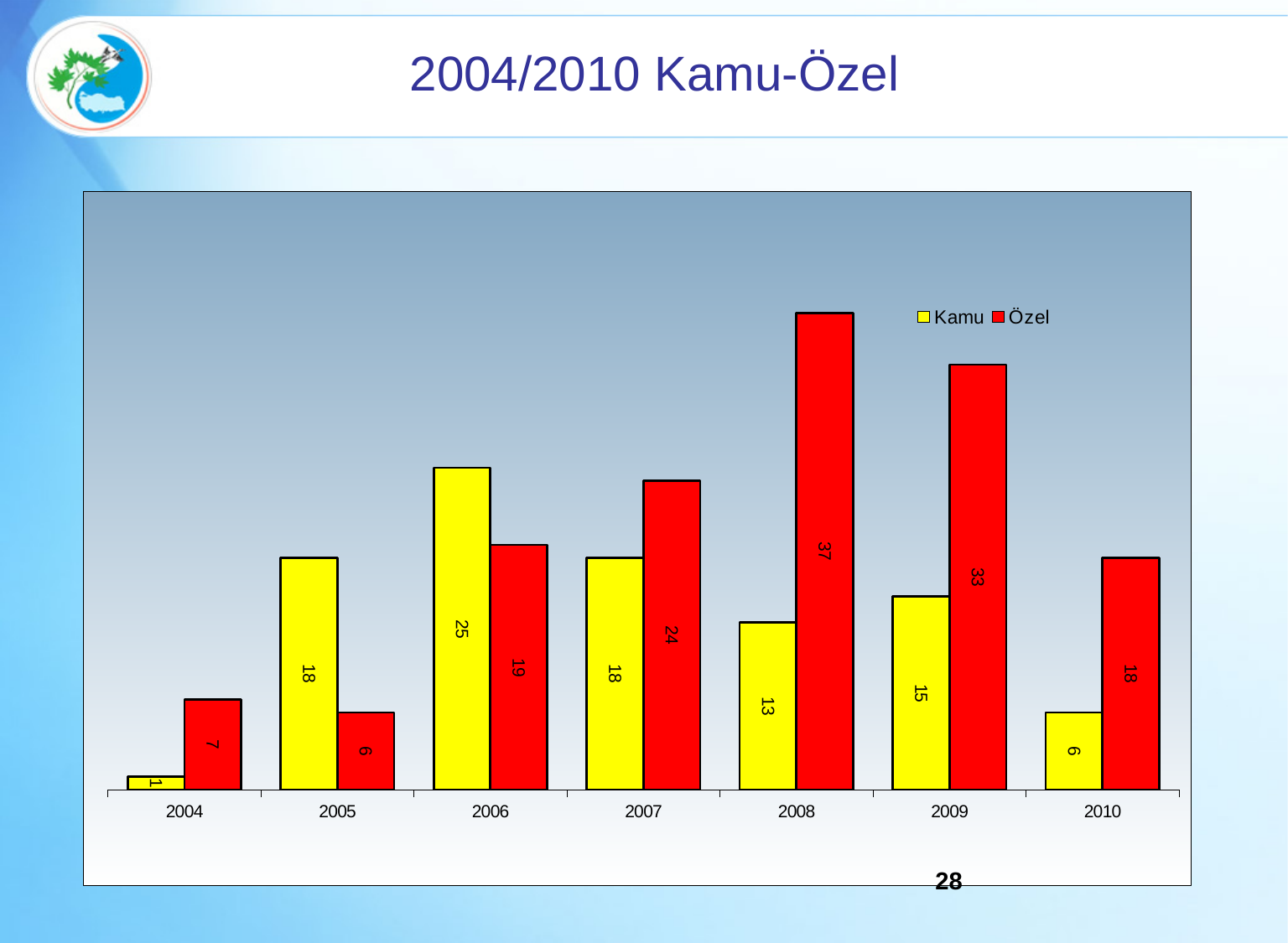
What is the Kamu value for 2006? 25 What colour are the Özel bars? red What is the Özel value for 2008? 37 Which year has the lowest Kamu value? 2004 What is the difference between the Özel and Kamu values in 2009? 18 What kind of chart is shown on the slide? bar chart Which year has the highest Özel value? 2008 Which is larger in 2005, Kamu or Özel? Kamu What is the Kamu value for 2004? 1 How many series does the legend list? 2 How many years are shown on the x axis? 7 What is the combined Kamu and Özel value for 2010? 24